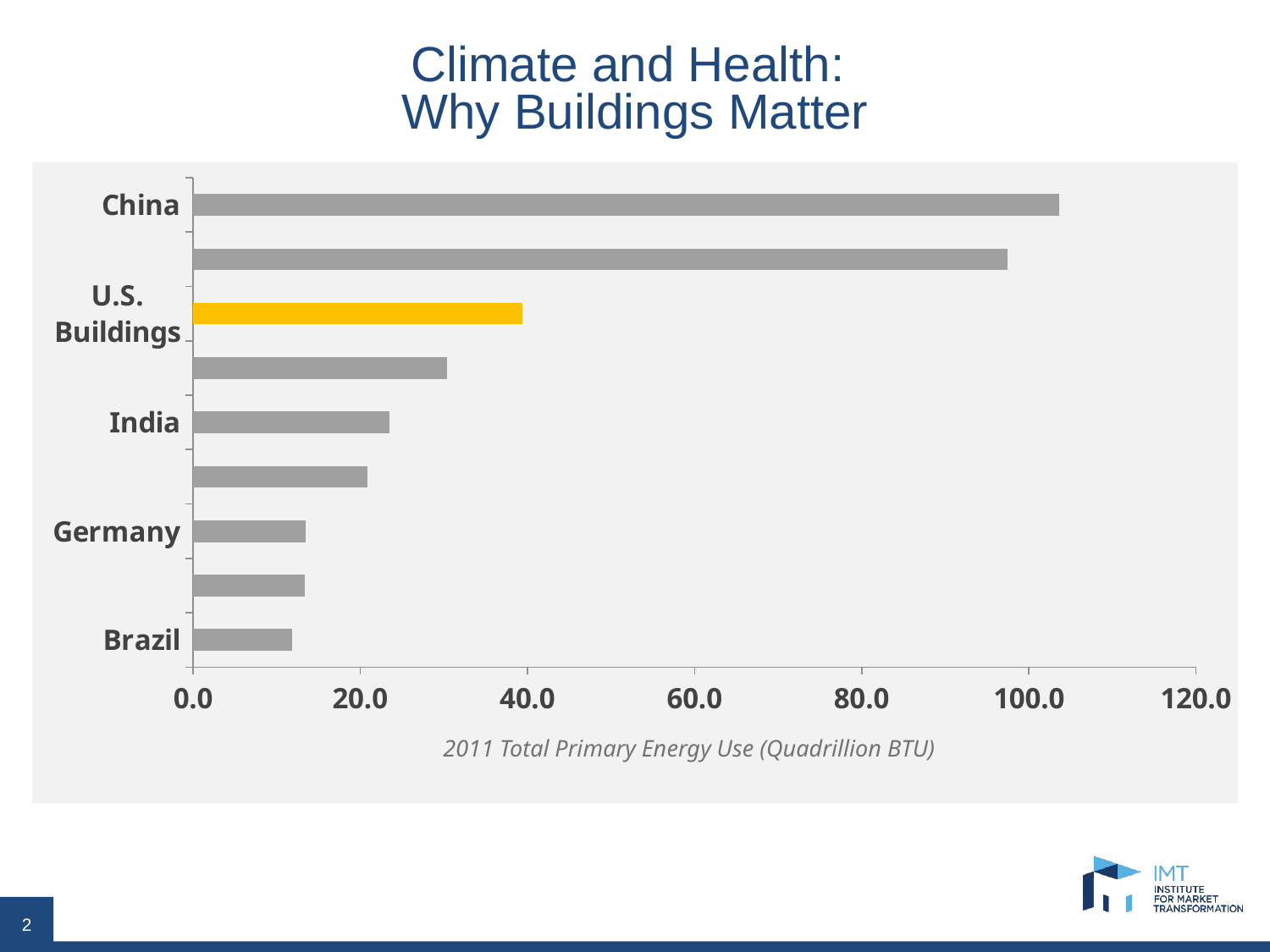
What is the title of the horizontal axis? 2011 Total Primary Energy Use (Quadrillion BTU) Which labeled category has the longest bar? China Is the value for U.S. Buildings greater or less than 20.0? greater Is the value for Germany greater or less than 20.0? less How many bars are plotted in the chart? 9 Is the value for Brazil greater or less than 20.0? less What kind of chart is shown on the slide? bar chart Which is larger, the value for India or the value for Germany? India Which category's bar is highlighted in yellow? U.S. Buildings Which is larger, the value for China or the value for U.S. Buildings? China